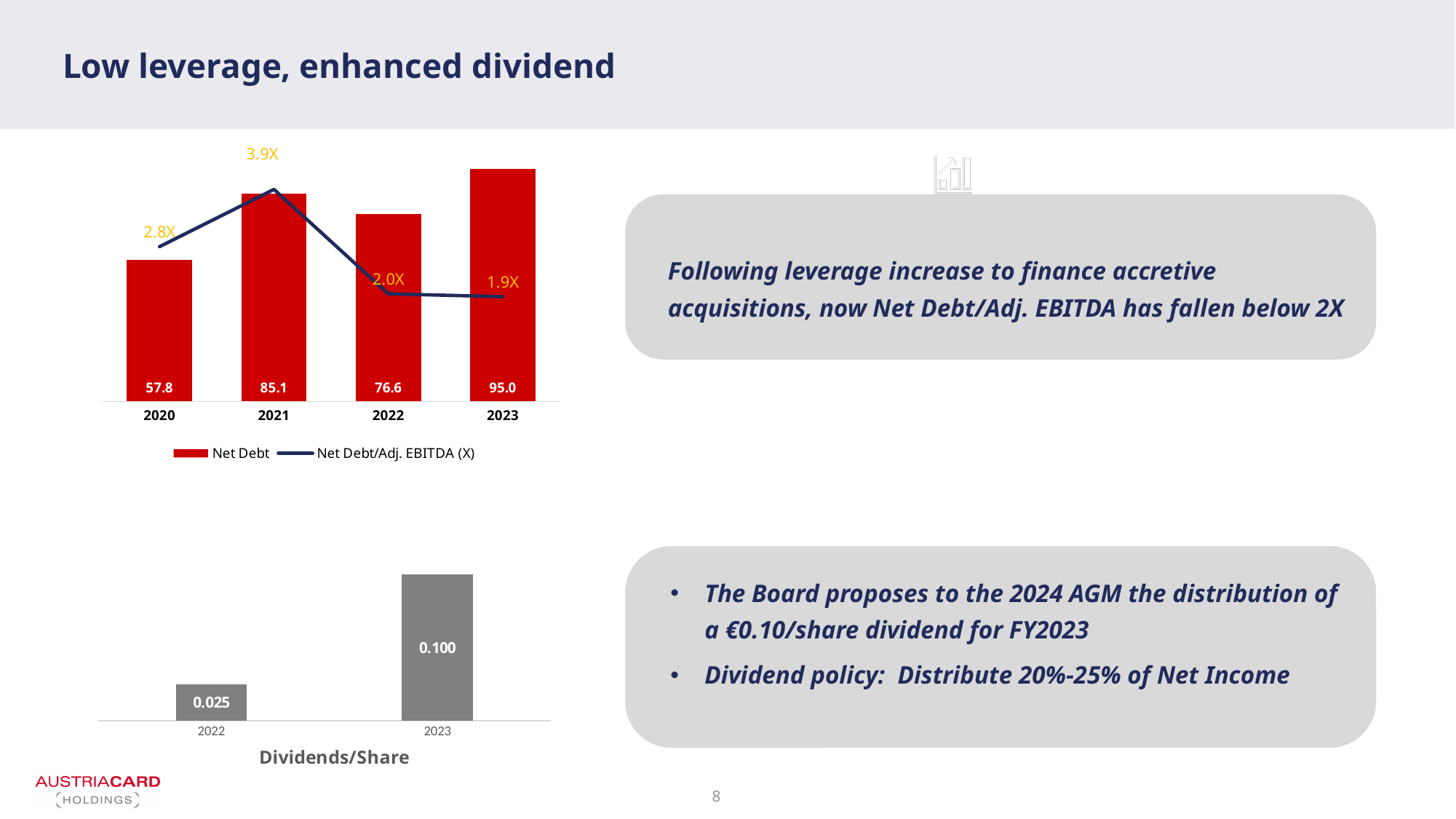
In the bottom chart (Dividends/Share), what is the value for 2023? 0.100 In the top chart (Net Debt), which year has the lowest Net Debt/Adj. EBITDA (X)? 2023 In the top chart (Net Debt), is Net Debt higher in 2021 or in 2022? 2021 In the bottom chart (Dividends/Share), what is the difference between the 2023 and 2022 values? 0.075 In the top chart (Net Debt), does the Net Debt/Adj. EBITDA (X) line rise or fall from 2021 to 2023? fall In the top chart (Net Debt), which year has the highest Net Debt? 2023 What kind of chart is the bottom chart (Dividends/Share)? bar chart In the top chart (Net Debt), what is the Net Debt/Adj. EBITDA (X) value for 2021? 3.9X In the top chart (Net Debt), how many series does the legend list? 2 In the top chart (Net Debt), what is the difference in Net Debt between 2021 and 2020? 27.3 In the top chart (Net Debt), what is the Net Debt value for 2023? 95.0 In the top chart (Net Debt), how many years are shown on the x axis? 4